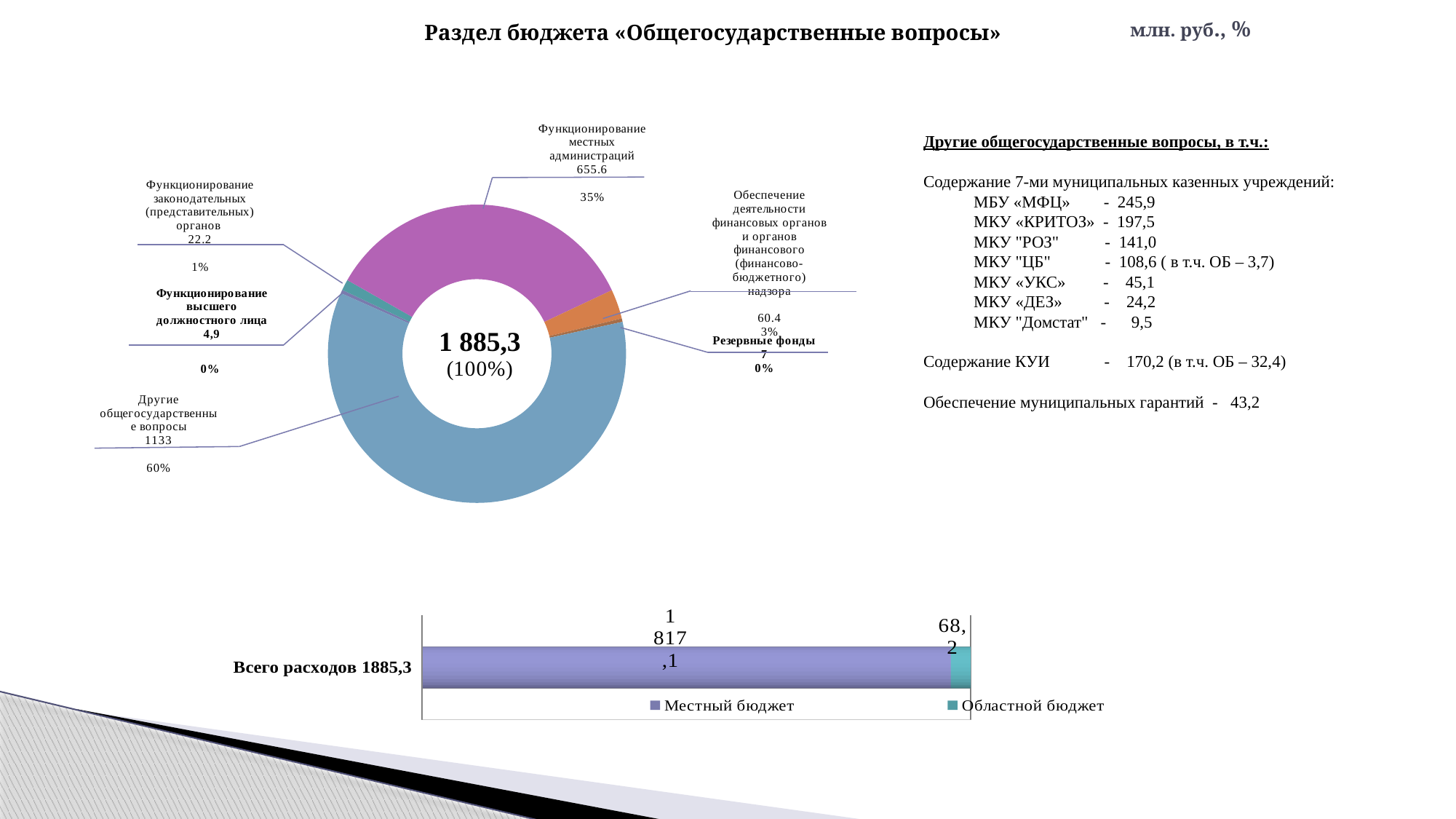
How many series does the legend of the bottom bar chart list? 2 In the donut chart, what is the value for «Резервные фонды»? 7 In the donut chart, which category has the smallest value? Функционирование высшего должностного лица In the donut chart, what is the difference between «Функционирование местных администраций» (655.6) and «Обеспечение деятельности финансовых органов» (60.4)? 595.2 How many categories does the donut chart show? 6 In the bottom bar chart, what is the value for «Местный бюджет»? 1 817,1 In the donut chart, what is the value for «Функционирование местных администраций»? 655.6 In the donut chart, which category has the largest value? Другие общегосударственные вопросы What total value is shown in the centre of the donut chart? 1 885,3 In the donut chart, which is larger: «Функционирование законодательных (представительных) органов» or «Функционирование высшего должностного лица»? Функционирование законодательных (представительных) органов In the donut chart, what share of the total is «Другие общегосударственные вопросы»? 60% In the bottom bar chart, what is the value for «Областной бюджет»? 68,2